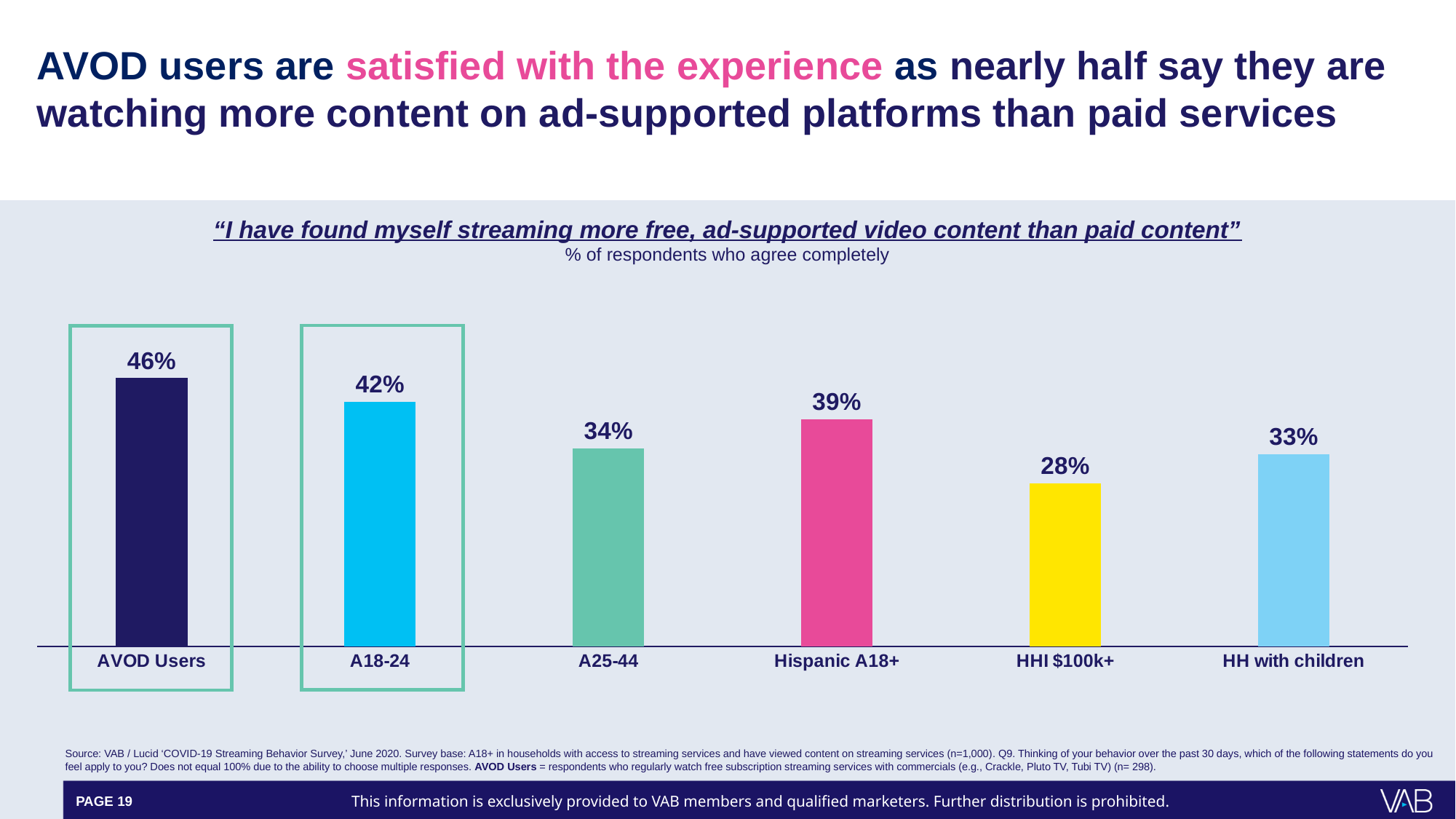
What percentage of AVOD Users agree completely that they have found themselves streaming more free, ad-supported video content than paid content? 46% Which two categories are highlighted with green outline boxes? AVOD Users and A18-24 What is the difference between the values for A18-24 and A25-44? 8 percentage points Which is larger, the value for Hispanic A18+ or the value for HH with children? Hispanic A18+ What is the difference between the values for AVOD Users and HHI $100k+? 18 percentage points What is the value shown for A18-24? 42% Which category has the lowest value? HHI $100k+ What kind of chart is shown on the slide? Bar chart How many categories are shown in the chart? 6 What is the value shown for HH with children? 33% What is the value shown for Hispanic A18+? 39% Which category has the highest value? AVOD Users